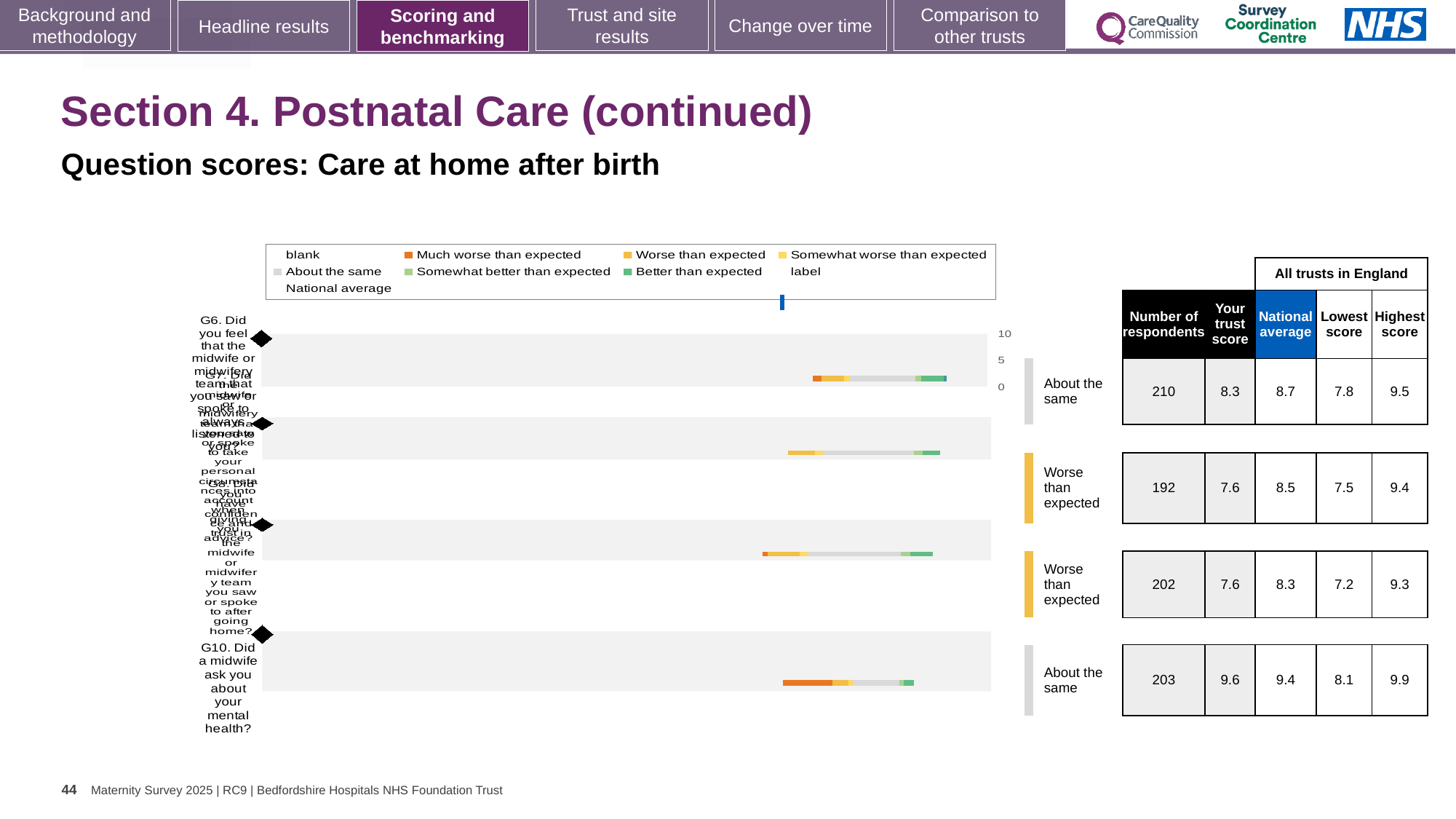
What benchmark category is shown for G10 (Did a midwife ask you about your mental health?)? About the same How many questions (rows) are plotted in the chart? 4 What is the trust score for G10 (Did a midwife ask you about your mental health?)? 9.6 What is the national average for G10 (Did a midwife ask you about your mental health?)? 9.4 What kind of chart is shown on the slide? bar chart For G10, what is the difference between the highest score and the lowest score across all trusts in England? 1.8 For G10, which is larger: the trust score or the national average? trust score For the first row of the chart (G6), how much higher is the national average than the trust score? 0.4 What is the highest score across all trusts in England for the first row of the chart (G6)? 9.5 Which question has the highest trust score? G10 How many respondents are listed for G10 (Did a midwife ask you about your mental health?)? 203 What is the trust score for the first row of the chart (G6)? 8.3